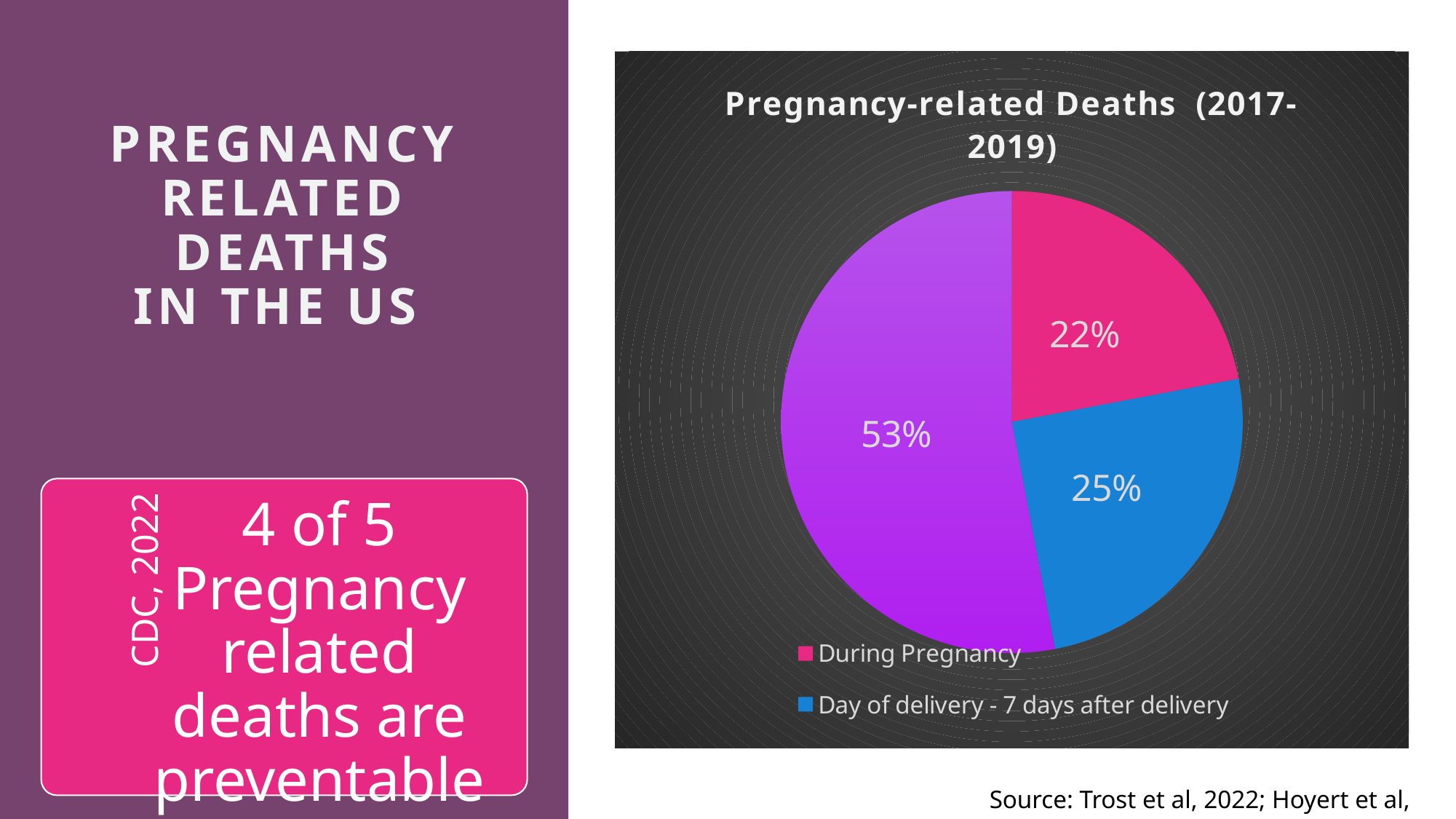
What type of chart is shown on the slide? Pie chart What share of pregnancy-related deaths occurred During Pregnancy? 22% What is the difference in percentage points between the largest slice (53%) and the During Pregnancy slice? 31 percentage points What share of pregnancy-related deaths occurred from the Day of delivery - 7 days after delivery? 25% What percentage is shown on the largest slice of the pie chart? 53% What colour is the During Pregnancy slice? Pink Which is larger: the share for During Pregnancy or the share for Day of delivery - 7 days after delivery? Day of delivery - 7 days after delivery How many entries are listed in the chart's legend? 2 What is the difference in percentage points between the Day of delivery - 7 days after delivery slice and the During Pregnancy slice? 3 percentage points How many slices does the pie chart have? 3 What is the title of the chart? Pregnancy-related Deaths (2017-2019) What percentage is shown on the smallest slice of the pie chart? 22%